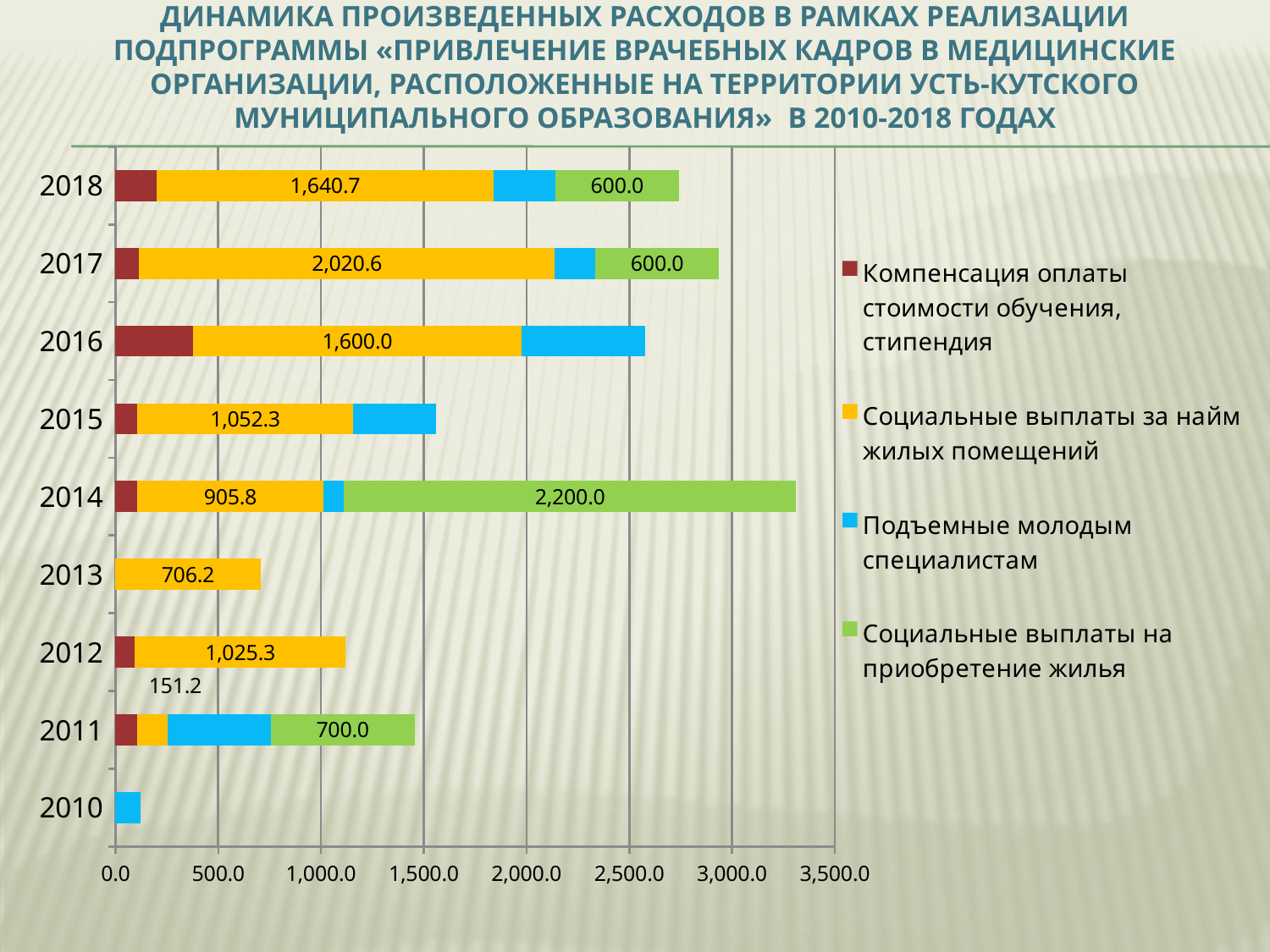
Which is larger: 'Социальные выплаты на приобретение жилья' in 2014 or in 2011? 2014 How many years (categories) are shown on the chart? 9 Which year has the shortest total bar? 2010 In which year is the value of 'Социальные выплаты за найм жилых помещений' the highest? 2017 How many series does the legend list? 4 What is the difference between the 'Социальные выплаты за найм жилых помещений' values for 2017 and 2018? 379.9 What is the value of 'Социальные выплаты на приобретение жилья' for 2014? 2,200.0 What is the value of 'Социальные выплаты за найм жилых помещений' for 2017? 2,020.6 What is the value of 'Социальные выплаты за найм жилых помещений' for 2013? 706.2 What kind of chart is shown on the slide? bar chart Is the total value of the bar for 2014 greater or less than 3,000.0? greater Which year has the longest total bar? 2014